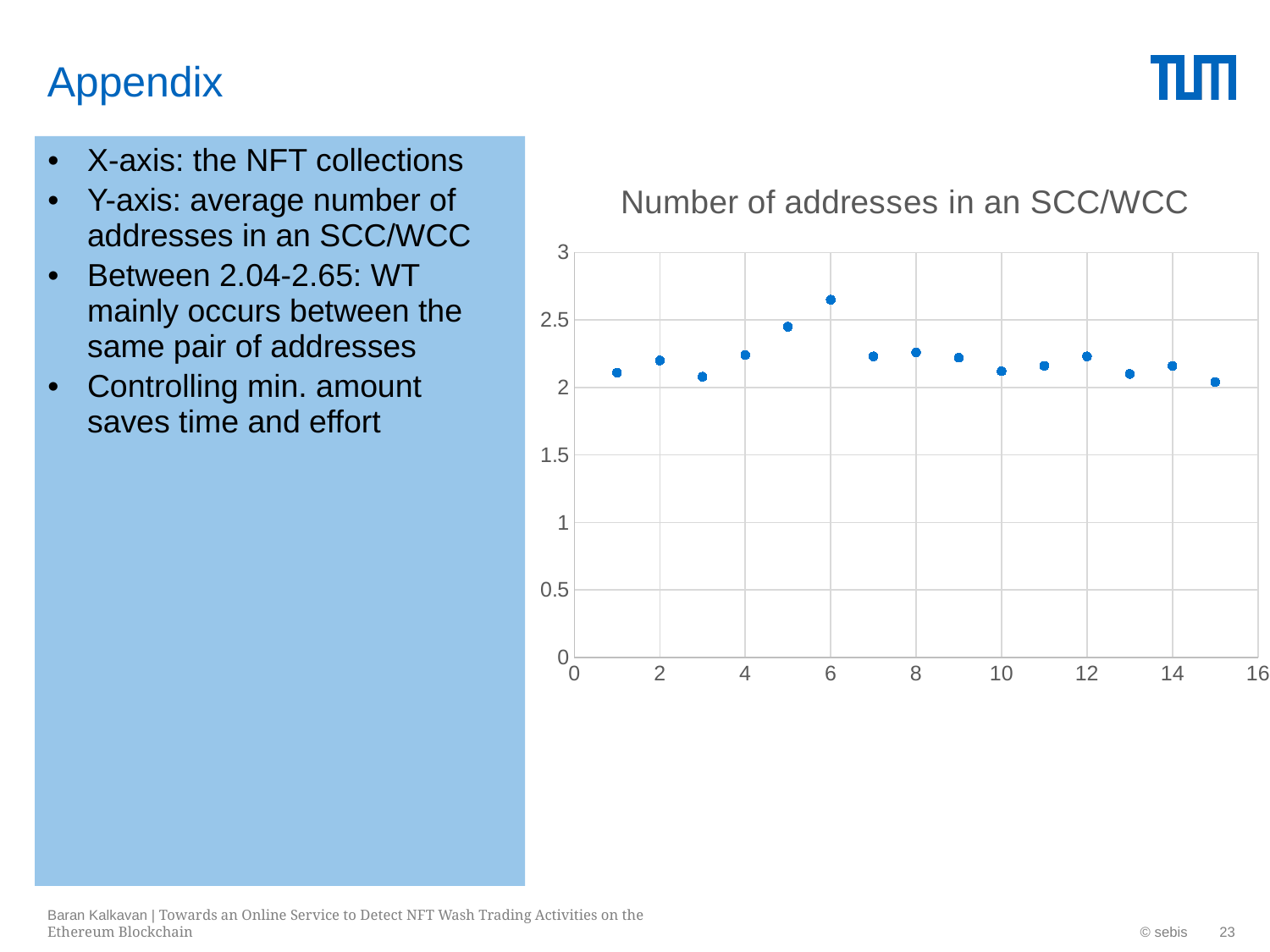
Which has the larger value, the point at x = 6 or the point at x = 1? x = 6 How many data points are plotted in the chart? 15 Which has the larger value, the point at x = 5 or the point at x = 3? x = 5 Is the value at x = 10 greater or less than 2.5? less Is the value at x = 1 greater or less than 2? greater Is the value at x = 6 greater or less than 2.5? greater What is the title of the chart? Number of addresses in an SCC/WCC At which x value does the chart reach its highest point? 6 What kind of chart is shown on the slide? scatter chart What is the highest value shown on the y axis? 3 Do the values rise or fall from x = 3 to x = 6? rise